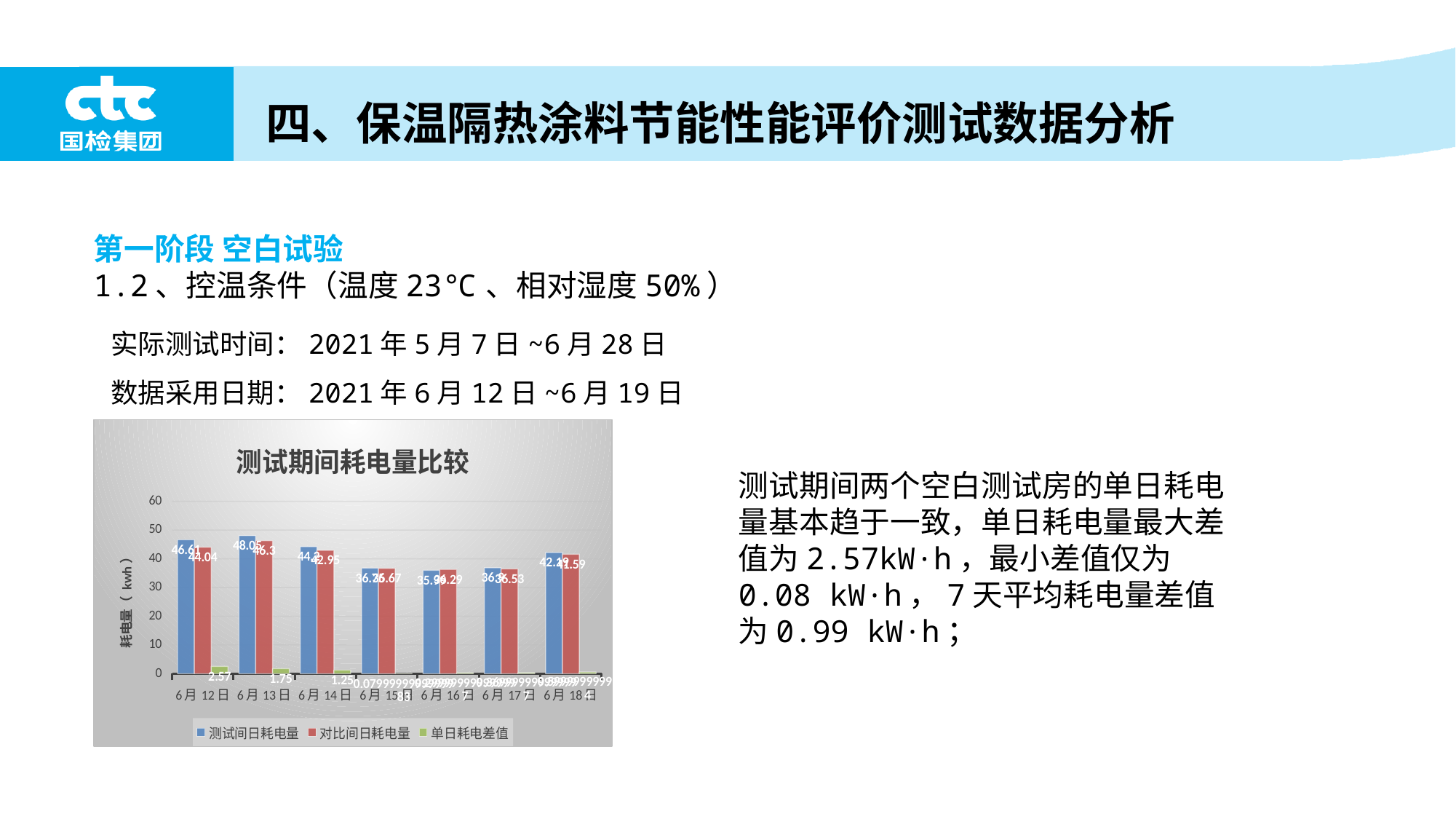
On which date is the 测试间日耗电量 highest? 6月13日 How many dates are shown on the x axis of the chart? 7 What is the title of the chart? 测试期间耗电量比较 On 6月12日, which is larger: 测试间日耗电量 or 对比间日耗电量? 测试间日耗电量 What is the 对比间日耗电量 value for 6月13日? 46.3 On which date is the 单日耗电差值 highest? 6月12日 What type of chart is shown on the slide? bar chart Is the 对比间日耗电量 value for 6月15日 greater or less than 40? less How many series does the chart legend list? 3 What is the 测试间日耗电量 value for 6月12日? 46.61 What is the difference between 测试间日耗电量 and 对比间日耗电量 on 6月13日? 1.75 What is the 单日耗电差值 value for 6月14日? 1.25